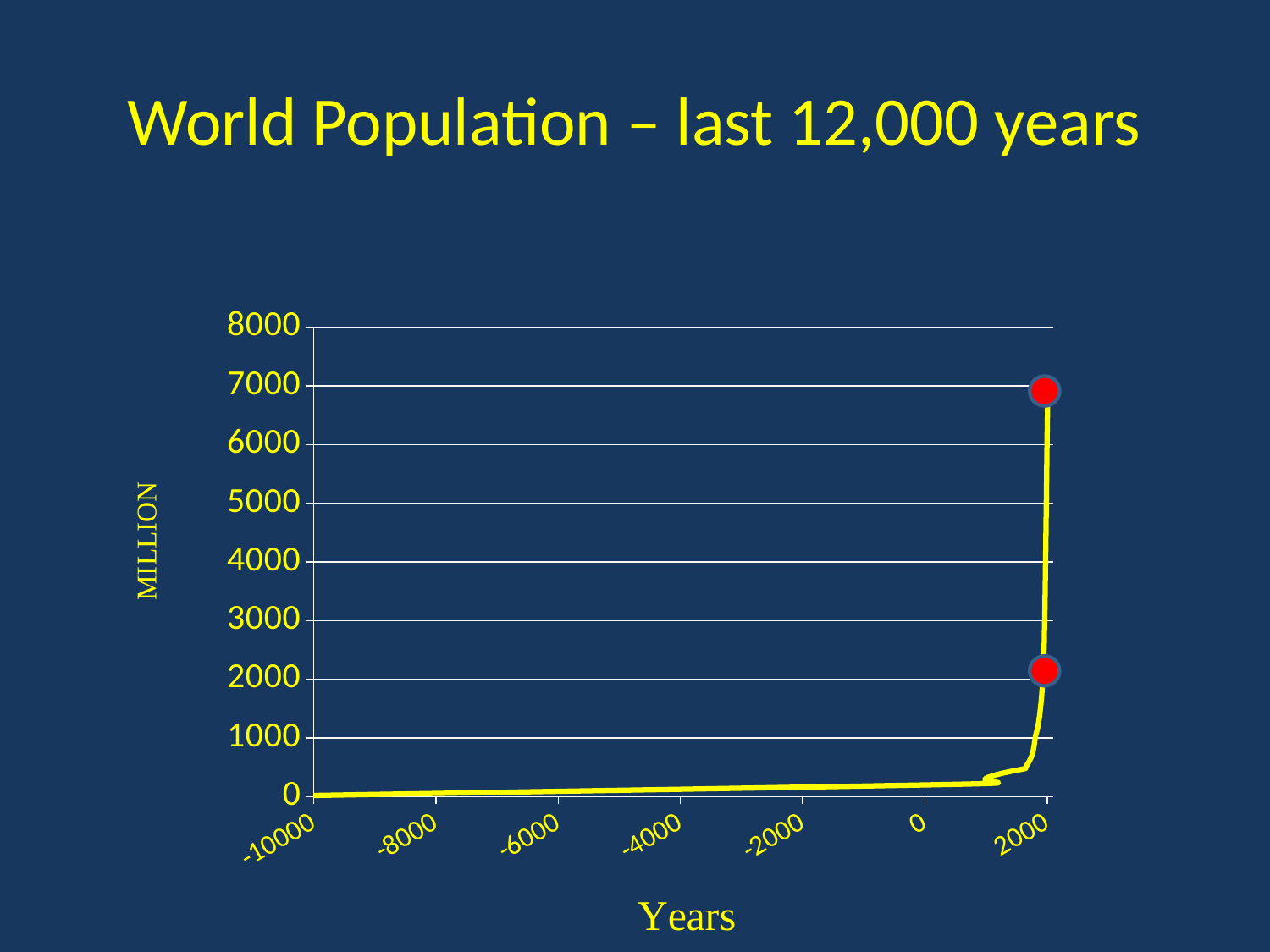
Is the value for the year -4000 greater or less than 2000? less What is the maximum value shown on the vertical axis? 8000 How many red circular markers are highlighted on the line? 2 Is the value for the year 0 greater or less than 1000? less Does the world population rise or fall as the years move from -10000 toward 2000? rise Is the value for the year -10000 greater or less than 1000? less What is the title of the chart? World Population – last 12,000 years What is the label on the vertical axis? MILLION What kind of chart is shown on the slide? line chart